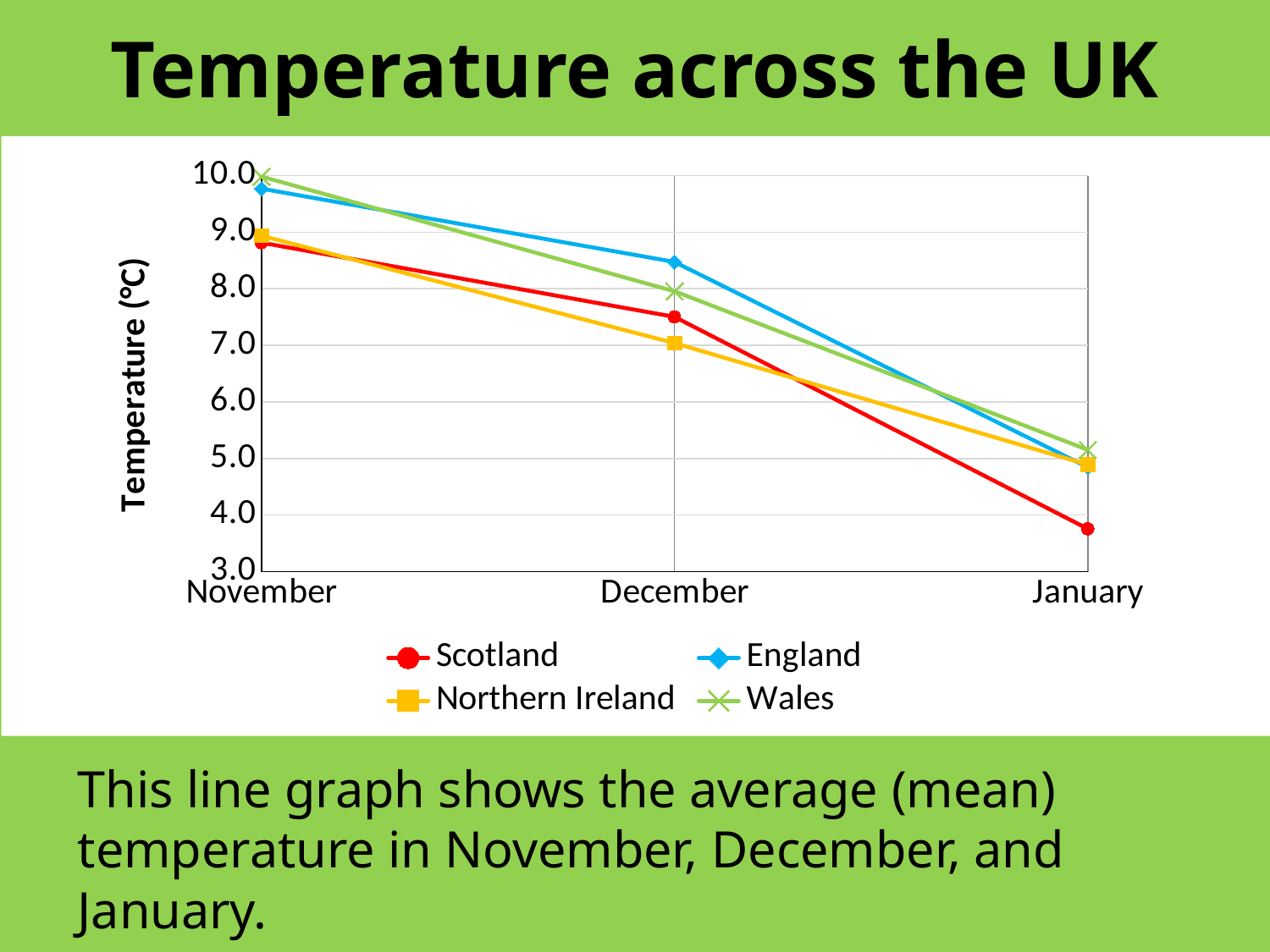
Which country has the highest temperature in November? Wales Which country has the lowest temperature in January? Scotland Is the value for Scotland in December greater or less than 7.0? greater In December, which is larger: the value for England or the value for Scotland? England How many months are plotted along the x axis? 3 How many series does the legend list? 4 Do the values for Scotland rise or fall from November to January? fall Is the value for Scotland in January greater or less than 4.0? less What is the title of the y axis? Temperature (°C) What kind of chart is shown on the slide? line chart Is the value for England in November greater or less than 9.0? greater